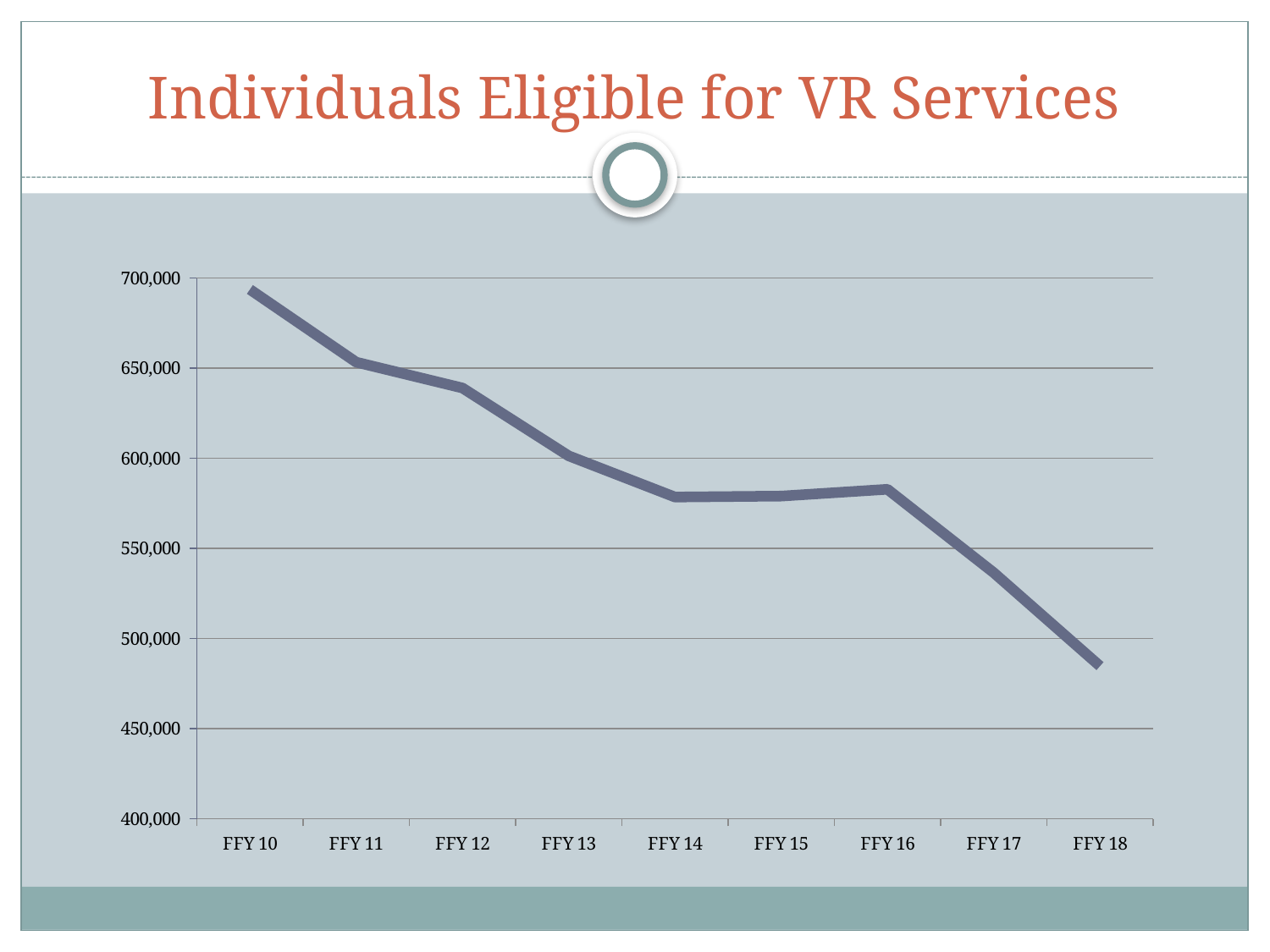
Overall, do the values rise or fall from FFY 10 to FFY 18? fall What is the title of the chart on the slide? Individuals Eligible for VR Services Is the value for FFY 17 greater or less than 500,000? greater Is the value for FFY 18 greater or less than 500,000? less Which is larger, the value for FFY 16 or the value for FFY 17? FFY 16 Which is larger, the value for FFY 12 or the value for FFY 16? FFY 12 What kind of chart is shown on the slide? line chart Is the value for FFY 10 greater or less than 650,000? greater Which fiscal year has the lowest number of individuals eligible for VR services? FFY 18 Which fiscal year has the highest number of individuals eligible for VR services? FFY 10 How many fiscal years are plotted along the x axis? 9